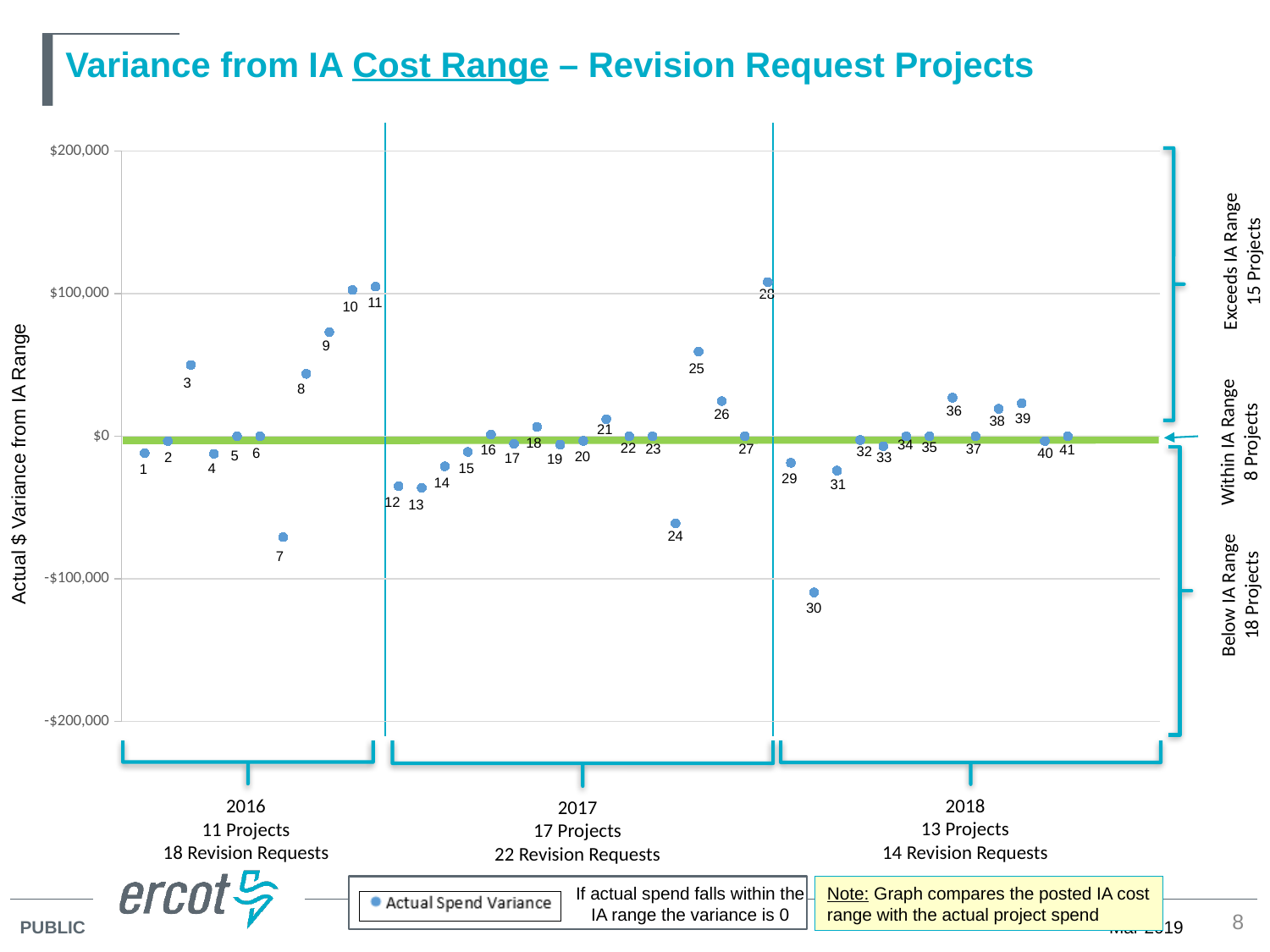
What is the name of the series shown in the legend? Actual Spend Variance What kind of chart is shown on the slide? scatter chart Is the value for point 24 greater or less than -$100,000? greater Is the value for point 28 greater or less than $100,000? greater Which has the larger value, point 25 or point 29? point 25 Is the value for point 3 greater or less than $0? greater Which numbered point has the lowest Actual $ Variance from IA Range? 30 How many data points are plotted on the chart? 41 How many series does the legend list? 1 What is the title of the vertical axis? Actual $ Variance from IA Range